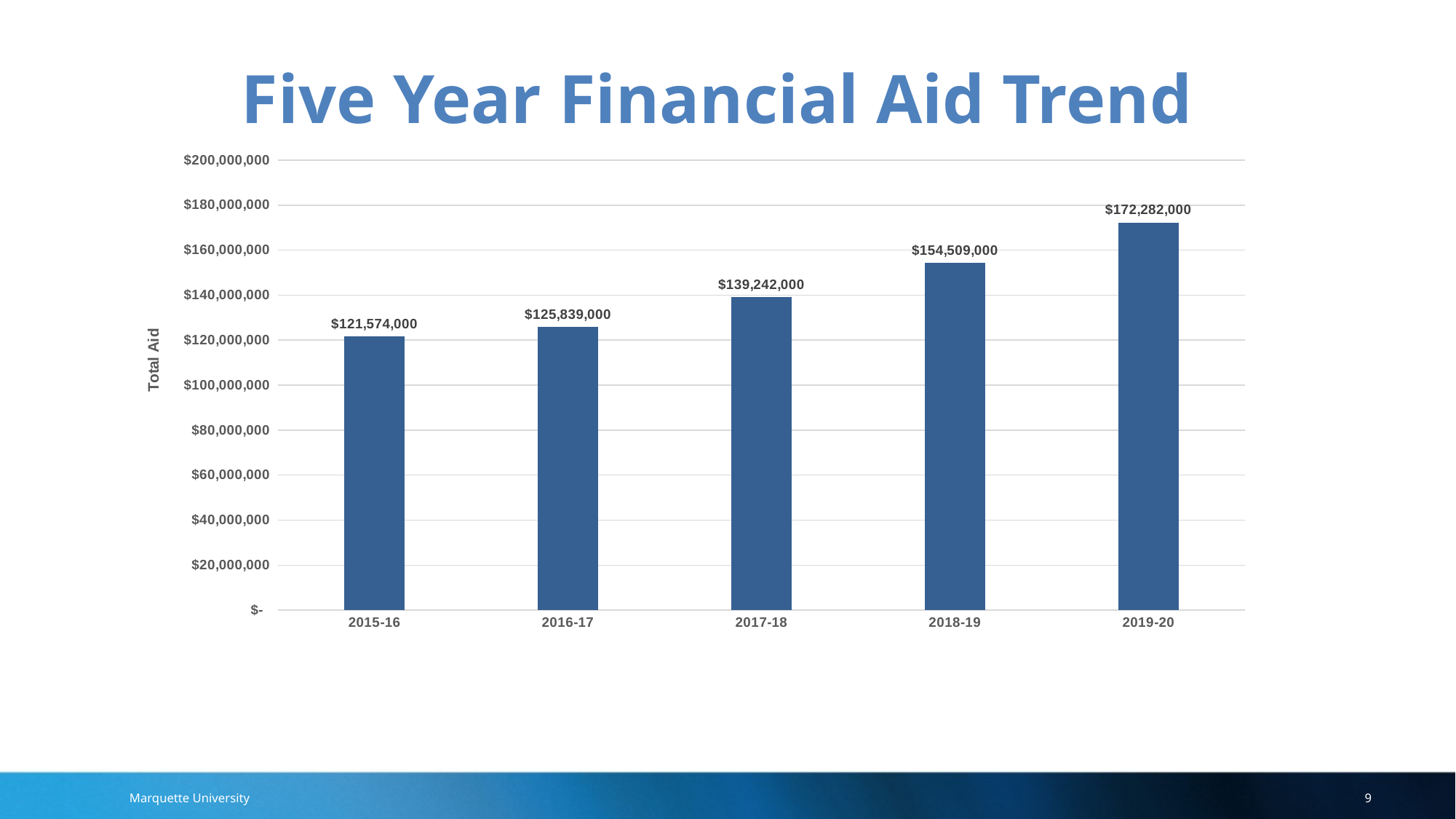
What is the difference in total aid between 2019-20 and 2018-19? $17,773,000 Which year has the highest total aid? 2019-20 Which year has a larger total aid value, 2017-18 or 2018-19? 2018-19 What is the difference in total aid between 2016-17 and 2015-16? $4,265,000 What is the total aid value for 2019-20? $172,282,000 Is the value for 2018-19 greater or less than $160,000,000? less Do the total aid values rise or fall from 2015-16 to 2019-20? Rise Which year has the lowest total aid? 2015-16 How many years are shown on the x axis? 5 What is the total aid value for 2017-18? $139,242,000 What kind of chart is shown on the slide? Bar chart What is the total aid value for 2015-16? $121,574,000